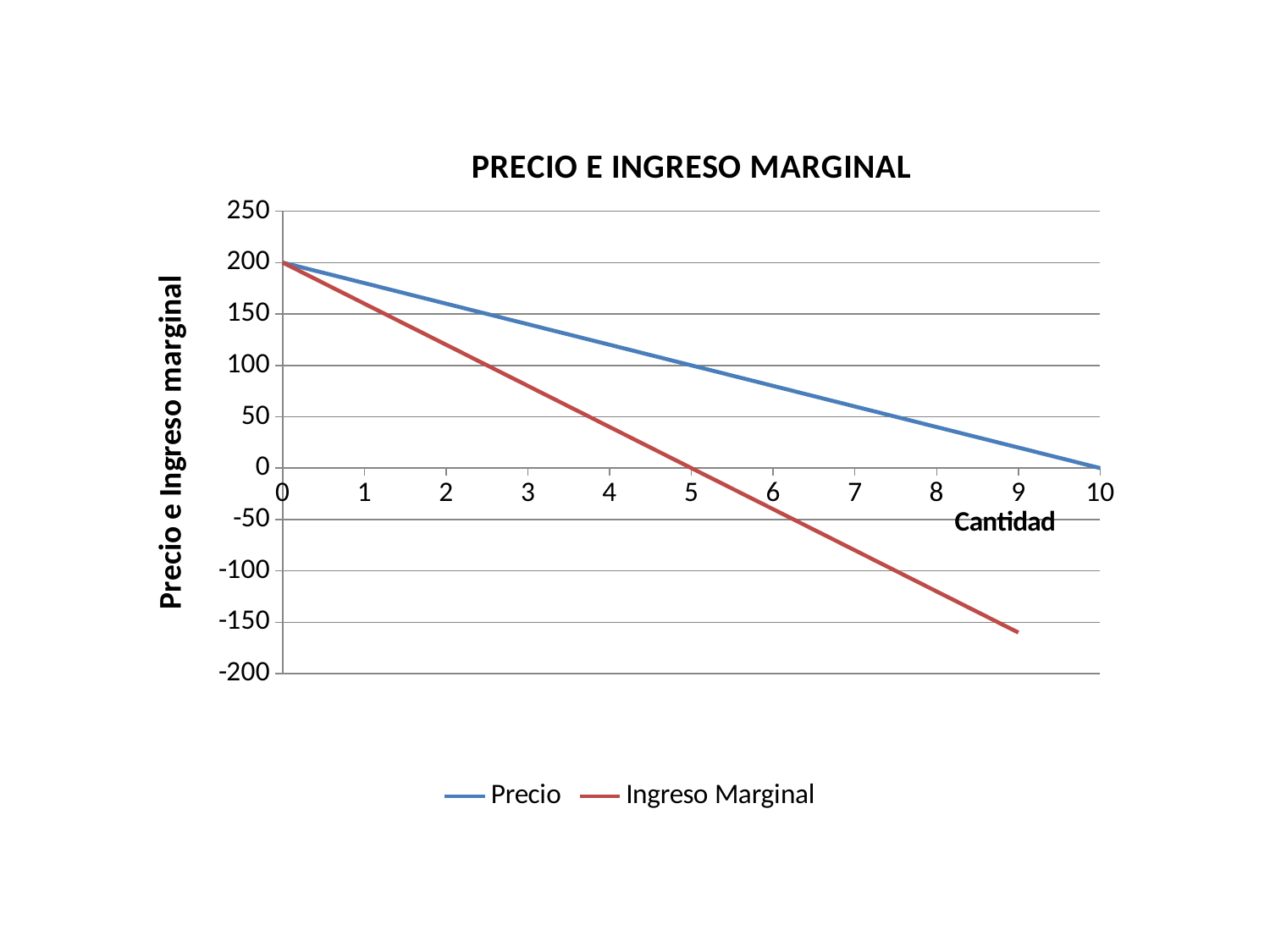
How many series does the legend list? 2 Is the value of Precio at Cantidad 2 greater or less than 150? greater What is the value of Precio at Cantidad 10? 0 What is the title of the chart? PRECIO E INGRESO MARGINAL Do the values of Precio rise or fall as Cantidad increases? fall Is the value of Ingreso Marginal at Cantidad 9 greater or less than -150? less What is the value of Precio at Cantidad 0? 200 What is the value of Precio at Cantidad 5? 100 What is the value of Ingreso Marginal at Cantidad 5? 0 What is the label of the x axis? Cantidad At Cantidad 8, which series has the larger value, Precio or Ingreso Marginal? Precio What kind of chart is shown on the slide? line chart